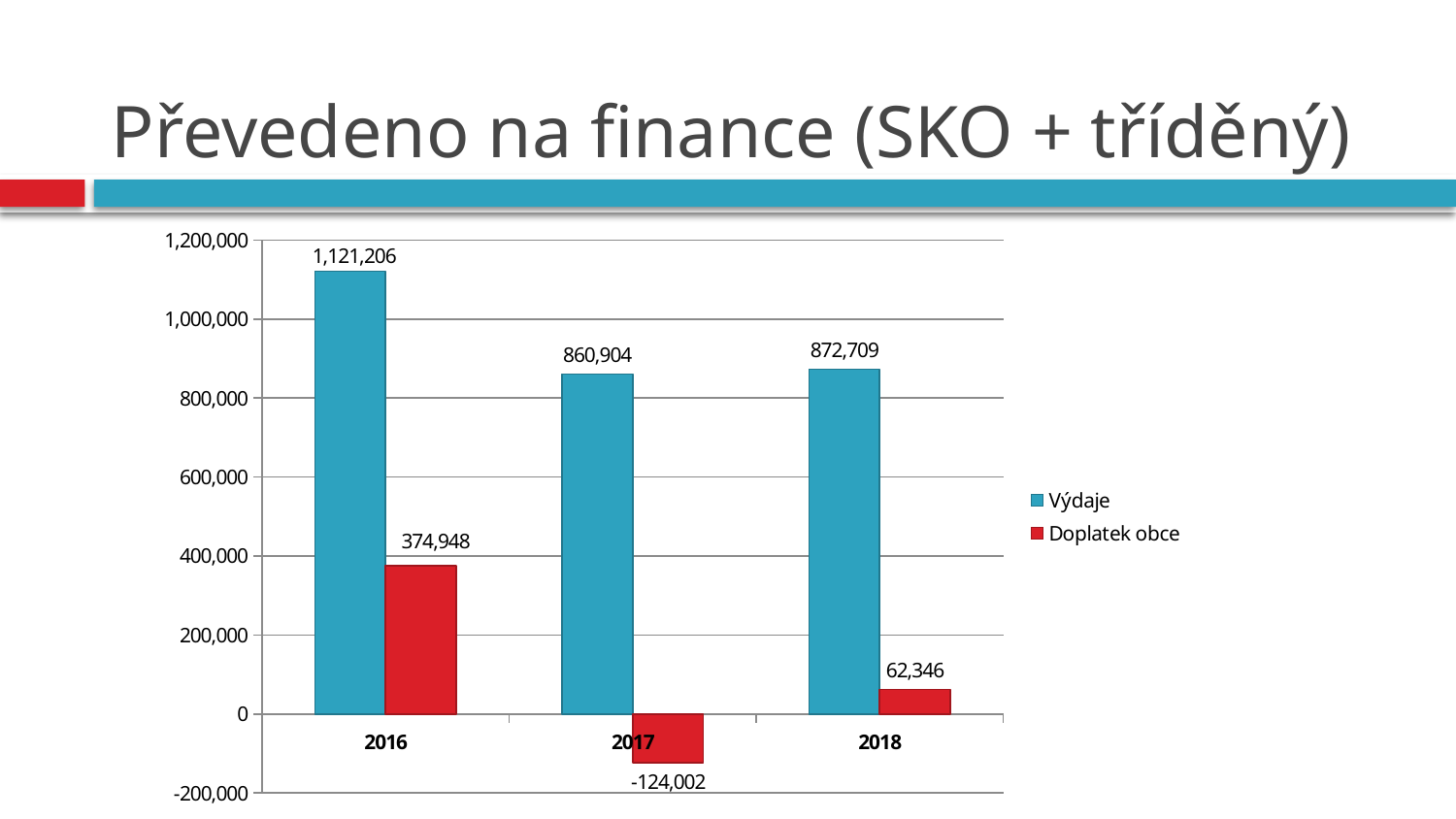
What kind of chart is shown on the slide? bar chart Which year has the highest Výdaje value? 2016 Which year has the lowest Doplatek obce value? 2017 How many years are shown on the x axis? 3 Is the value of Doplatek obce for 2016 greater or less than 200,000? greater What colour represents the Doplatek obce series? red Which is larger: Výdaje in 2018 or Výdaje in 2017? Výdaje in 2018 What is the difference between Výdaje in 2016 and Výdaje in 2017? 260,302 What is the value of Doplatek obce for 2018? 62,346 How many series does the legend list? 2 What is the value of Výdaje for 2016? 1,121,206 What is the value of Doplatek obce for 2017? -124,002